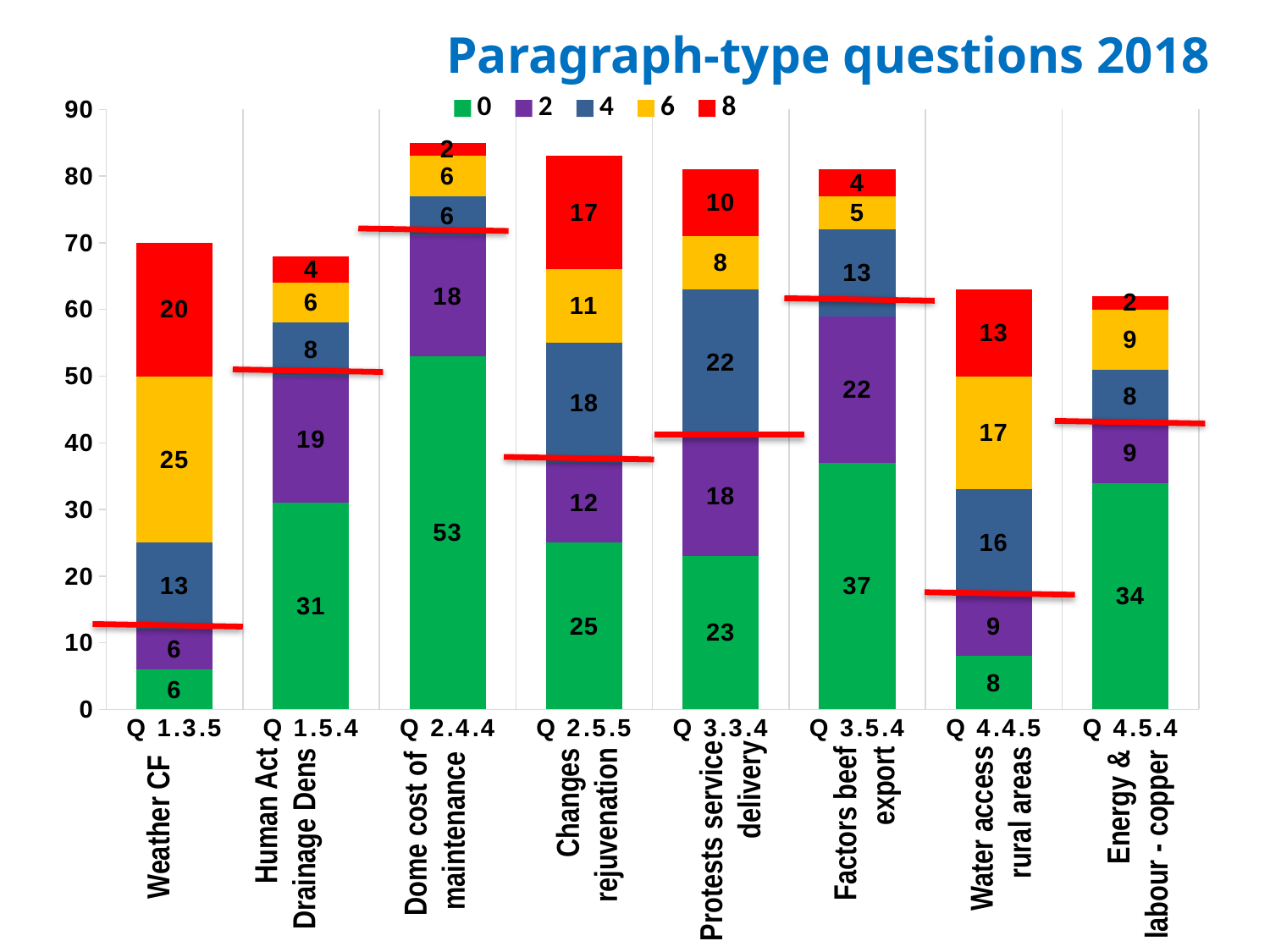
What is the difference between the '2' series values for Q 3.5.4 Factors beef export and Q 1.5.4 Human Act Drainage Dens? 3 What is the total of the stacked bar for Q 1.3.5 Weather CF? 70 Which is larger: the '8' series value for Q 2.5.5 Changes rejuvenation or for Q 4.4.5 Water access rural areas? Q 2.5.5 Changes rejuvenation What is the value of the '8' series for Q 1.3.5 Weather CF? 20 Which category has the highest value for the '0' series? Q 2.4.4 Dome cost of maintenance What is the total of the stacked bar for Q 4.5.4 Energy & labour - copper? 62 What kind of chart is shown on the slide? Stacked bar chart How many question categories are plotted along the x axis? 8 How many series does the legend list? 5 What is the value of the '6' series for Q 4.4.5 Water access rural areas? 17 What is the value of the '4' series for Q 3.3.4 Protests service delivery? 22 What is the value of the '0' series for Q 2.4.4 Dome cost of maintenance? 53